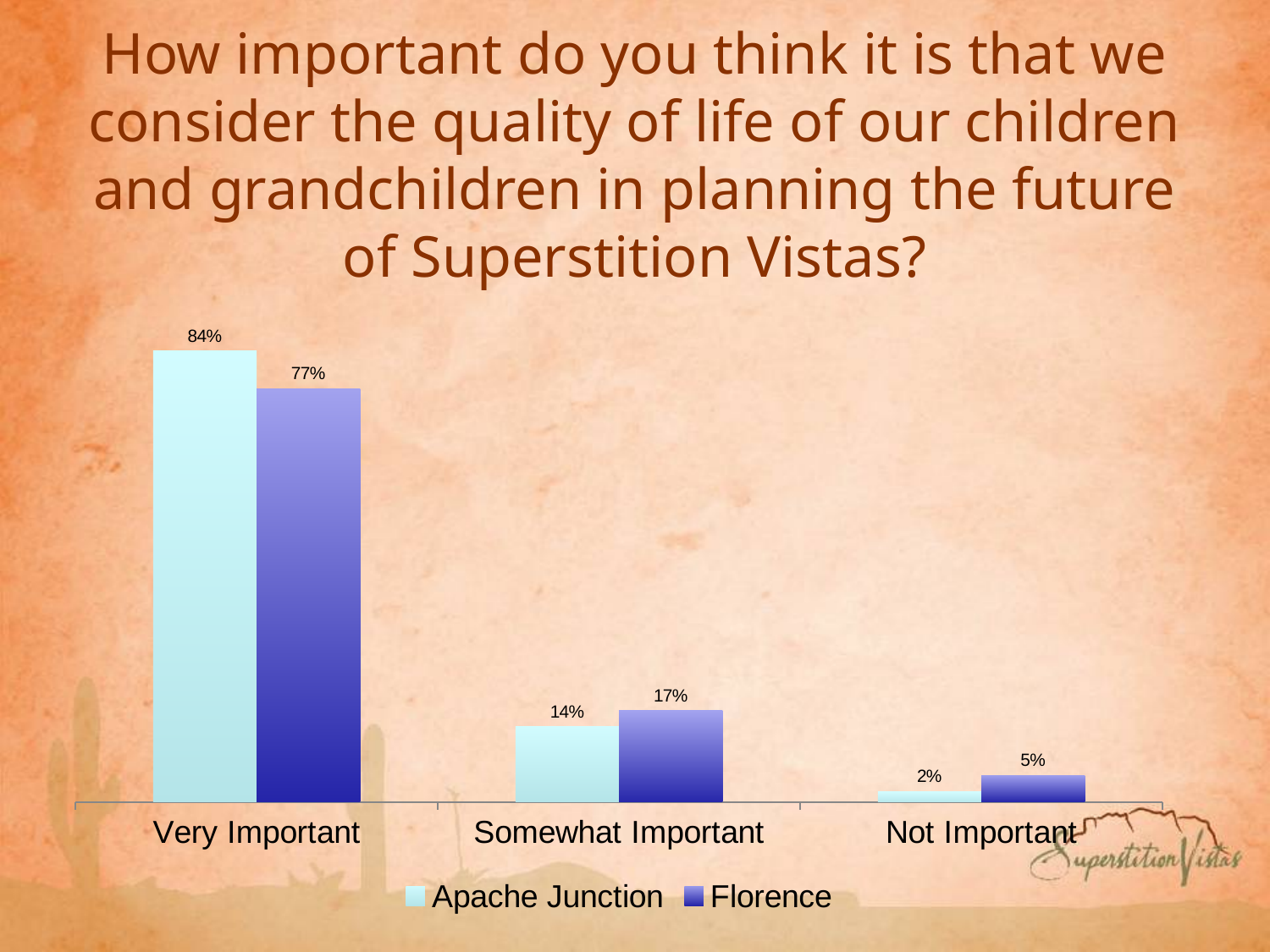
What is the difference between Apache Junction and Florence in the Very Important category? 7% How many response categories are shown on the x axis? 3 Which category has the highest value for Apache Junction? Very Important Do the Apache Junction values rise or fall from Very Important to Not Important? Fall What is the value for Florence in the Not Important category? 5% How many series does the legend list? 2 What percentage of Florence respondents said Somewhat Important? 17% Which category has the lowest value for Florence? Not Important Which is larger in the Somewhat Important category, Apache Junction or Florence? Florence What percentage of Apache Junction respondents said Very Important? 84% What kind of chart is shown on the slide? Bar chart Which series is shown in dark blue in the legend? Florence